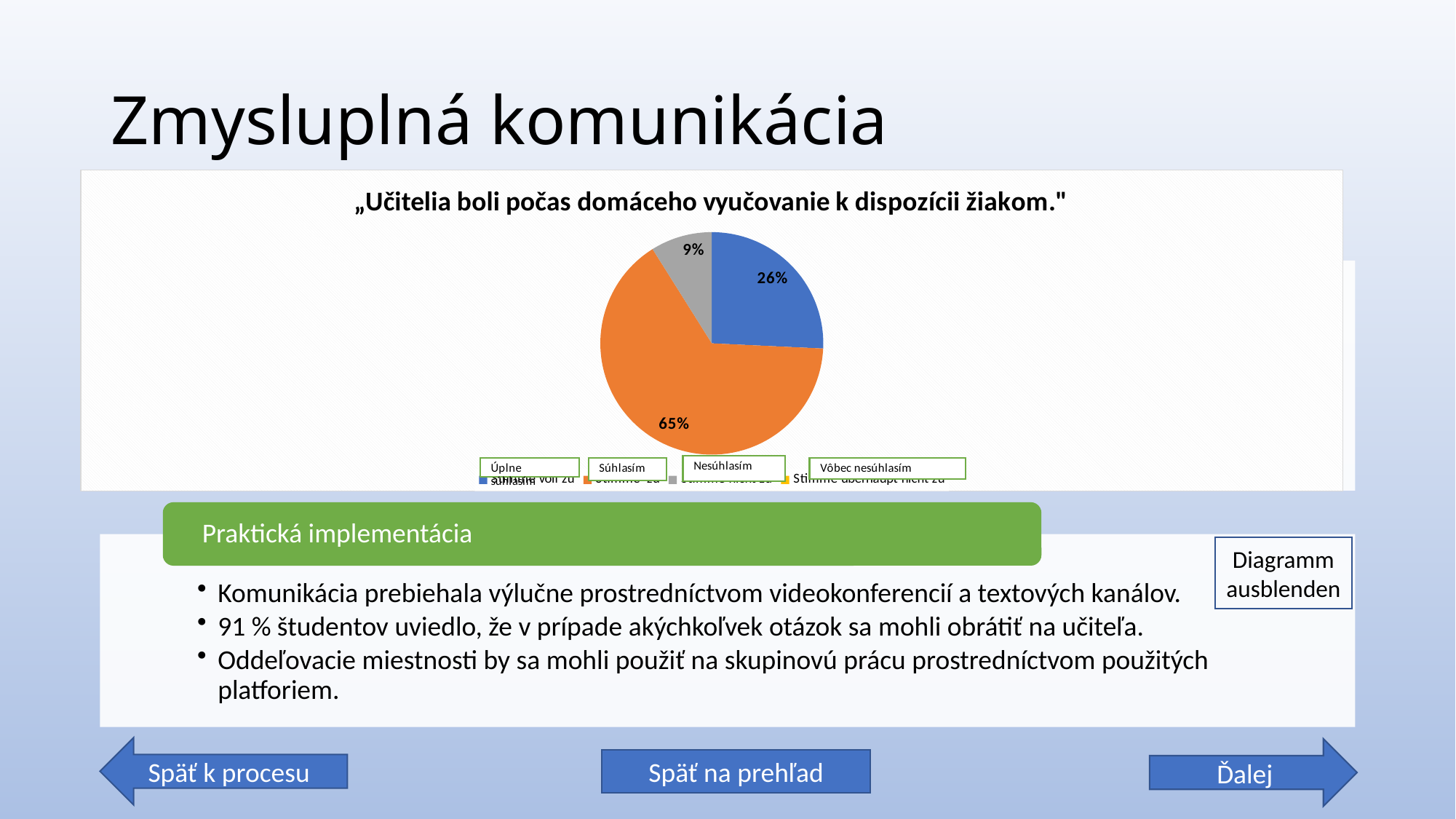
What percentage is shown for the smallest labelled slice of the pie chart? 9% What percentage is shown for the largest slice of the pie chart? 65% What percentage is shown for the blue slice of the pie chart? 26% What is the sum of the three labelled slices (26%, 65% and 9%) in the pie chart? 100% How many entries does the legend of the pie chart list? 4 What is the difference between the orange slice (65%) and the blue slice (26%) in the pie chart? 39% What percentage is shown for the orange slice of the pie chart? 65% What kind of chart is shown on the slide? pie chart Which slice is larger in the pie chart, the blue one or the grey one? the blue one What percentage is shown for the grey slice of the pie chart? 9% What is the title of the pie chart? „Učitelia boli počas domáceho vyučovanie k dispozícii žiakom." How many slices with percentage labels are visible in the pie chart? 3